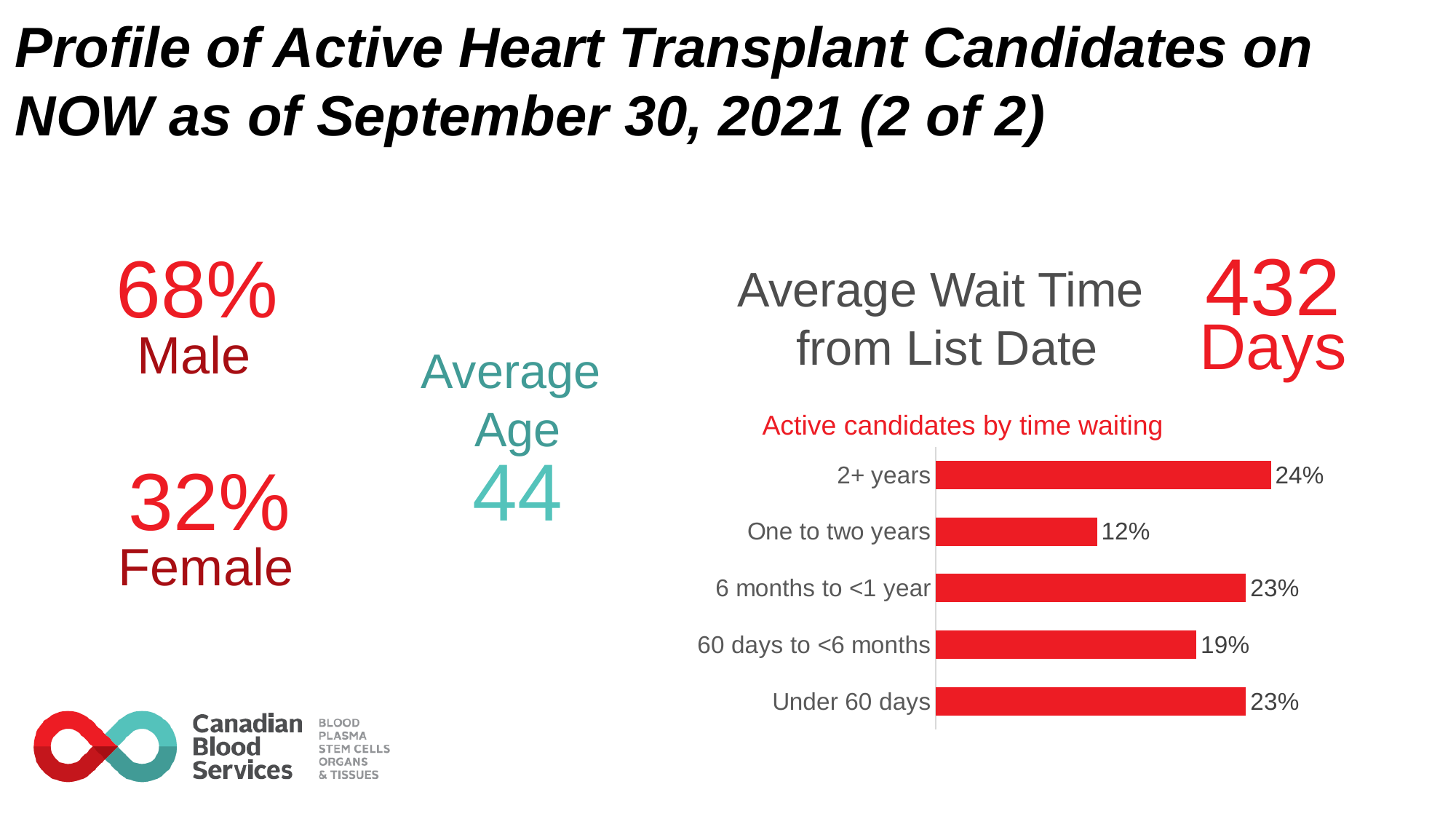
Which time-waiting category has the lowest share of active candidates? One to two years What is the difference in percentage points between the 2+ years category and the one to two years category? 12 What percentage of active candidates have been waiting one to two years? 12% What percentage of active candidates have been waiting 60 days to <6 months? 19% Which time-waiting category has the highest share of active candidates? 2+ years How many time-waiting categories are shown in the chart? 5 What is the title of the chart? Active candidates by time waiting What percentage of active candidates have been waiting 2+ years? 24% What percentage of active candidates have been waiting under 60 days? 23% What type of chart is used to show active candidates by time waiting? Bar chart What colour are the bars in the chart? Red Which is larger: the share for 6 months to <1 year or the share for 60 days to <6 months? 6 months to <1 year